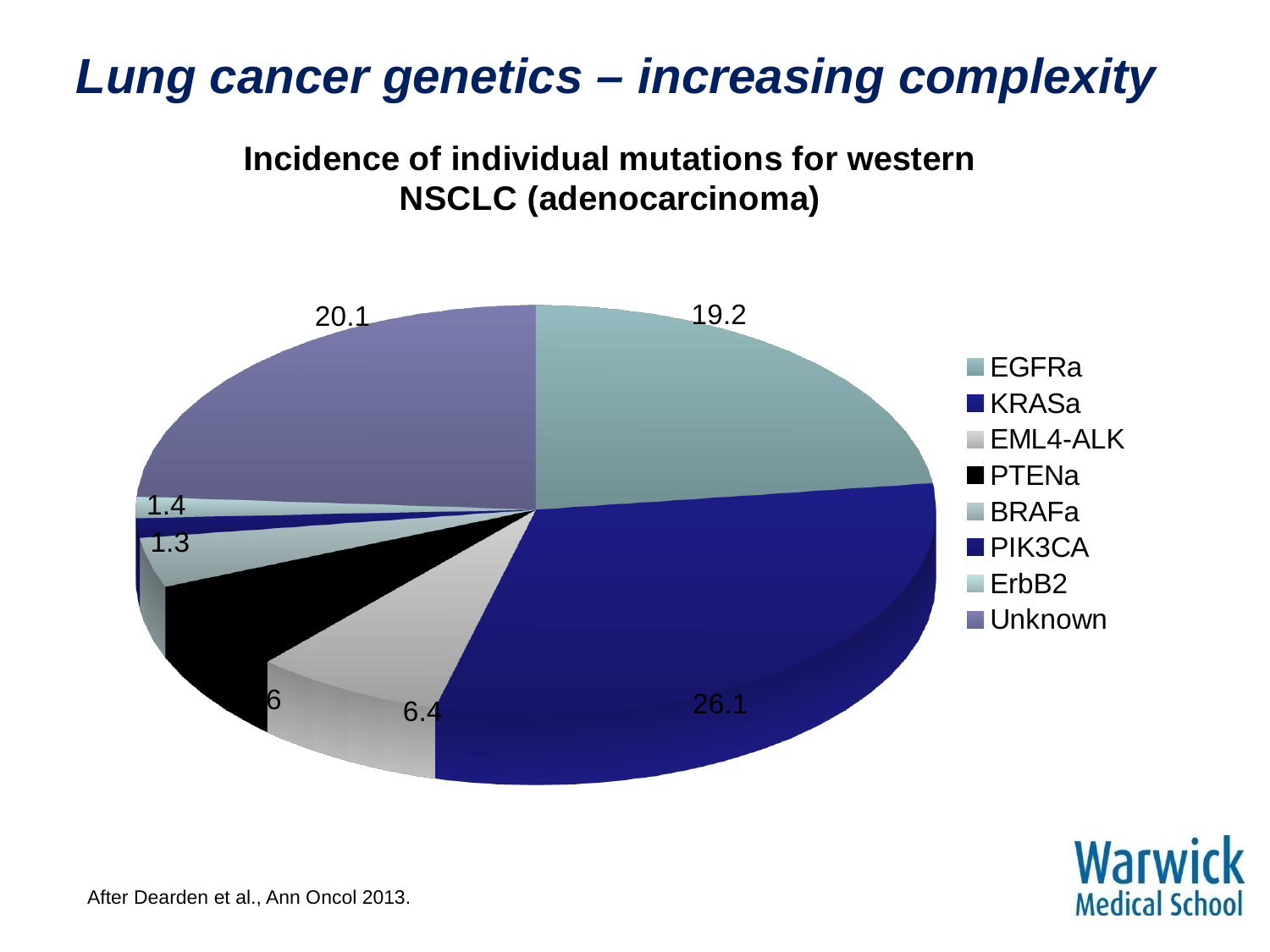
What is the difference between the values for Unknown and EGFRa? 0.9 What is the value shown for KRASa in the pie chart? 26.1 What is the difference between the values for KRASa and EGFRa? 6.9 What is the value shown for the Unknown slice in the pie chart? 20.1 What is the value shown for EML4-ALK in the pie chart? 6.4 What type of chart is shown on the slide? Pie chart What is the title of the chart on the slide? Incidence of individual mutations for western NSCLC (adenocarcinoma) How many categories does the legend of the pie chart list? 8 What is the value shown for EGFRa in the pie chart? 19.2 Which is larger, the value for KRASa or the value for EML4-ALK? KRASa Which is larger, the value for EGFRa or the value for Unknown? Unknown Which mutation category has the largest slice in the pie chart? KRASa